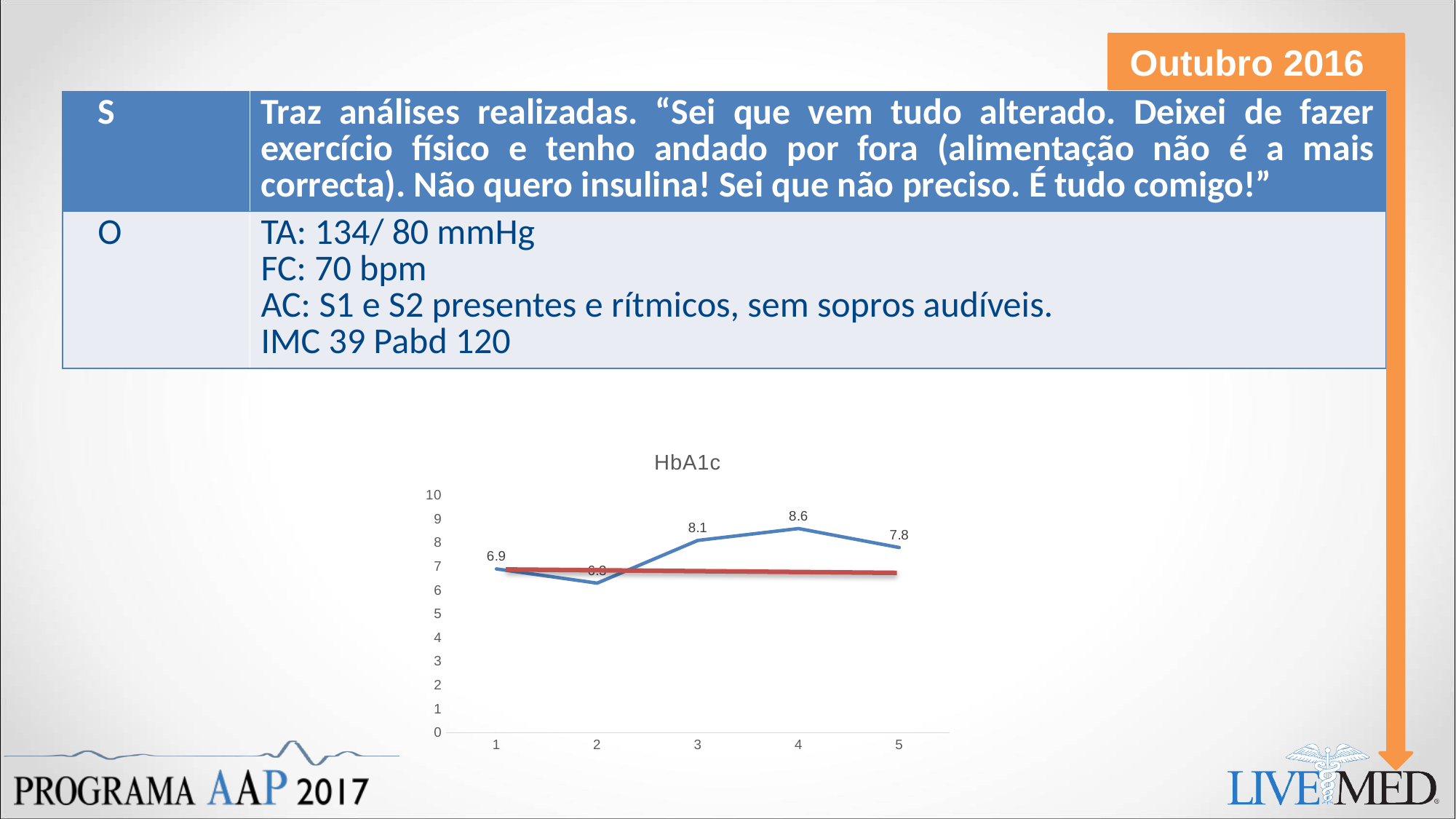
What is the HbA1c value at point 5? 7.8 What is the difference between the HbA1c values at point 4 and point 3? 0.5 Is the HbA1c value at point 2 greater or less than 7? less At which x-axis point is the HbA1c value lowest? 2 How many data points are plotted on the HbA1c chart? 5 What is the HbA1c value at point 4? 8.6 What is the difference between the HbA1c values at point 4 and point 5? 0.8 At which x-axis point is the HbA1c value highest? 4 What is the HbA1c value at point 3? 8.1 What is the HbA1c value at point 1? 6.9 What kind of chart is used to show HbA1c? line chart Which has the larger HbA1c value, point 1 or point 5? 5